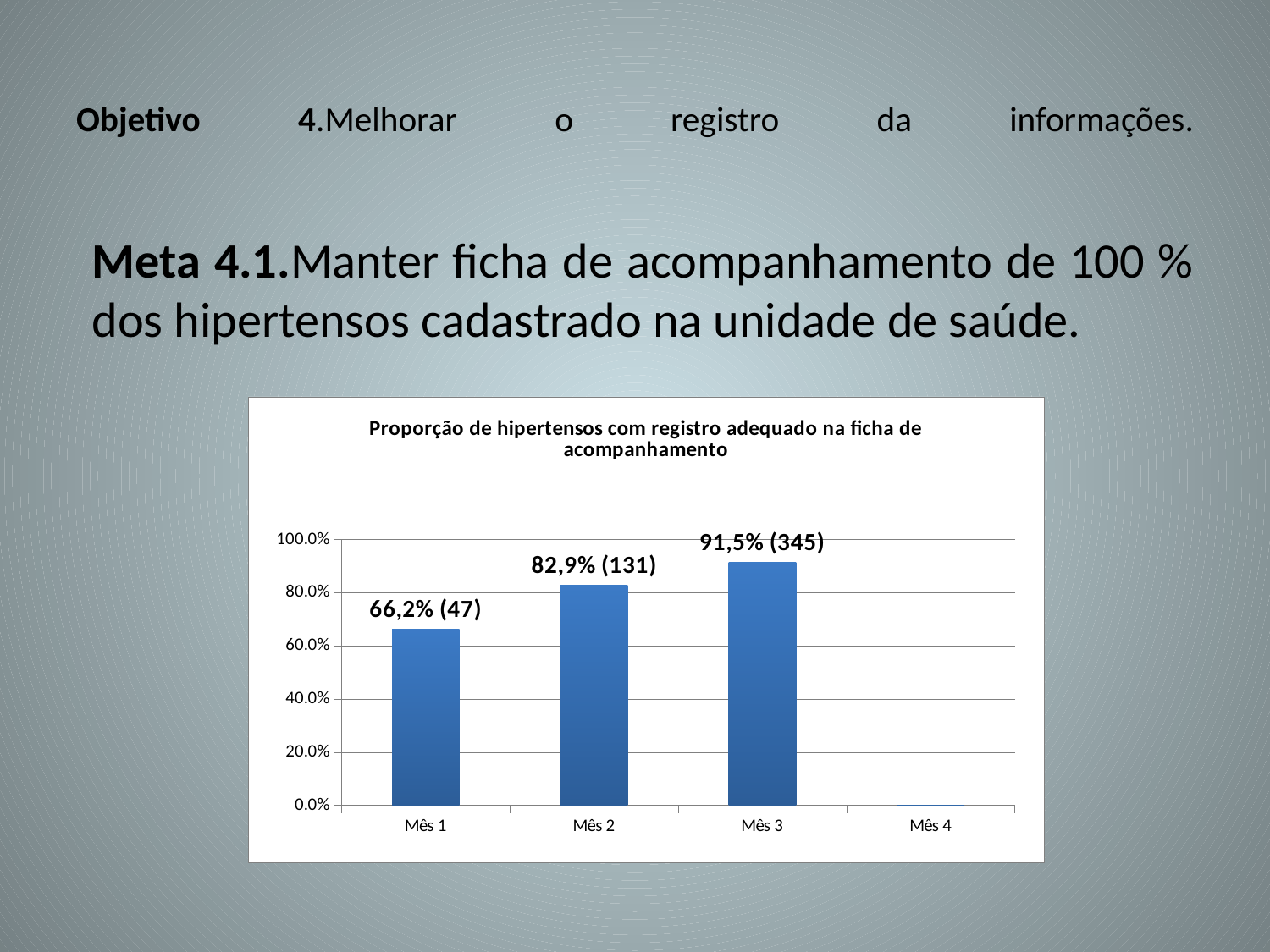
What is the value shown for Mês 2? 82,9% (131) What is the difference in percentage points between Mês 3 and Mês 1? 25,3 Which month has the highest proportion? Mês 3 Among the months with a plotted bar, which has the lowest proportion? Mês 1 Do the values rise or fall from Mês 1 to Mês 3? Rise What is the value shown for Mês 1? 66,2% (47) What is the title of the chart? Proporção de hipertensos com registro adequado na ficha de acompanhamento What is the value shown for Mês 3? 91,5% (345) What kind of chart is shown on the slide? Bar chart Which is larger, the value for Mês 2 or the value for Mês 1? Mês 2 Is the value for Mês 2 greater or less than 80.0%? greater How many month categories are shown on the x axis? 4